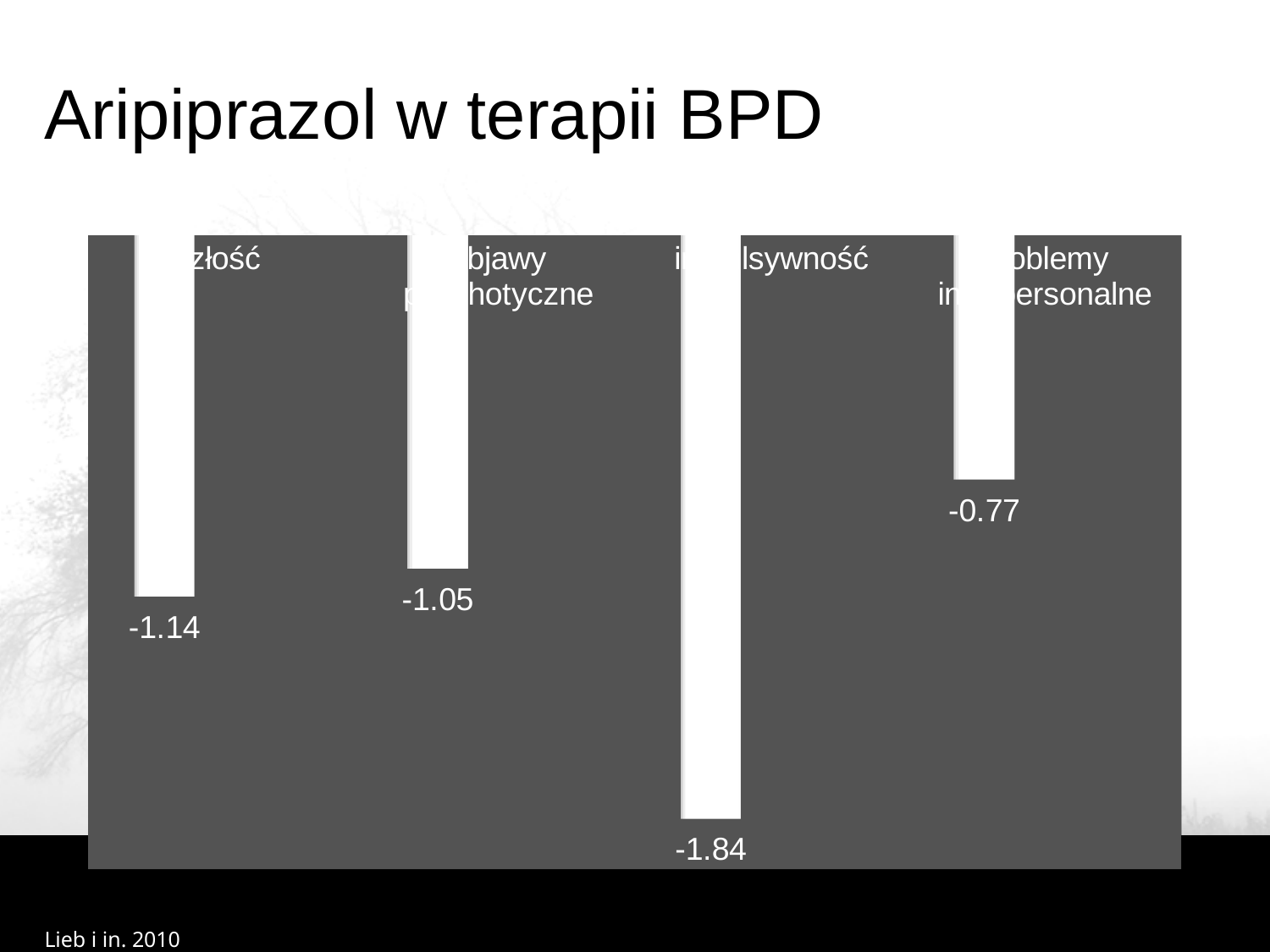
Which bar has the highest (least negative) value? The fourth bar (-0.77) What is the value shown for the fourth (rightmost) bar? -0.77 Which bar has the lowest (most negative) value? The third bar (-1.84) What is the value shown for the first (leftmost) bar? -1.14 How many bars are plotted in the chart? 4 Which has the larger value, the first bar or the second bar? The second bar (-1.05) What is the title of the slide containing the chart? Aripiprazol w terapii BPD What is the value shown for the third bar from the left? -1.84 What is the difference between the values of the first bar (-1.14) and the second bar (-1.05)? 0.09 What is the value shown for the second bar from the left? -1.05 What is the difference between the values of the third bar (-1.84) and the fourth bar (-0.77)? 1.07 What kind of chart is shown on the slide? Bar chart